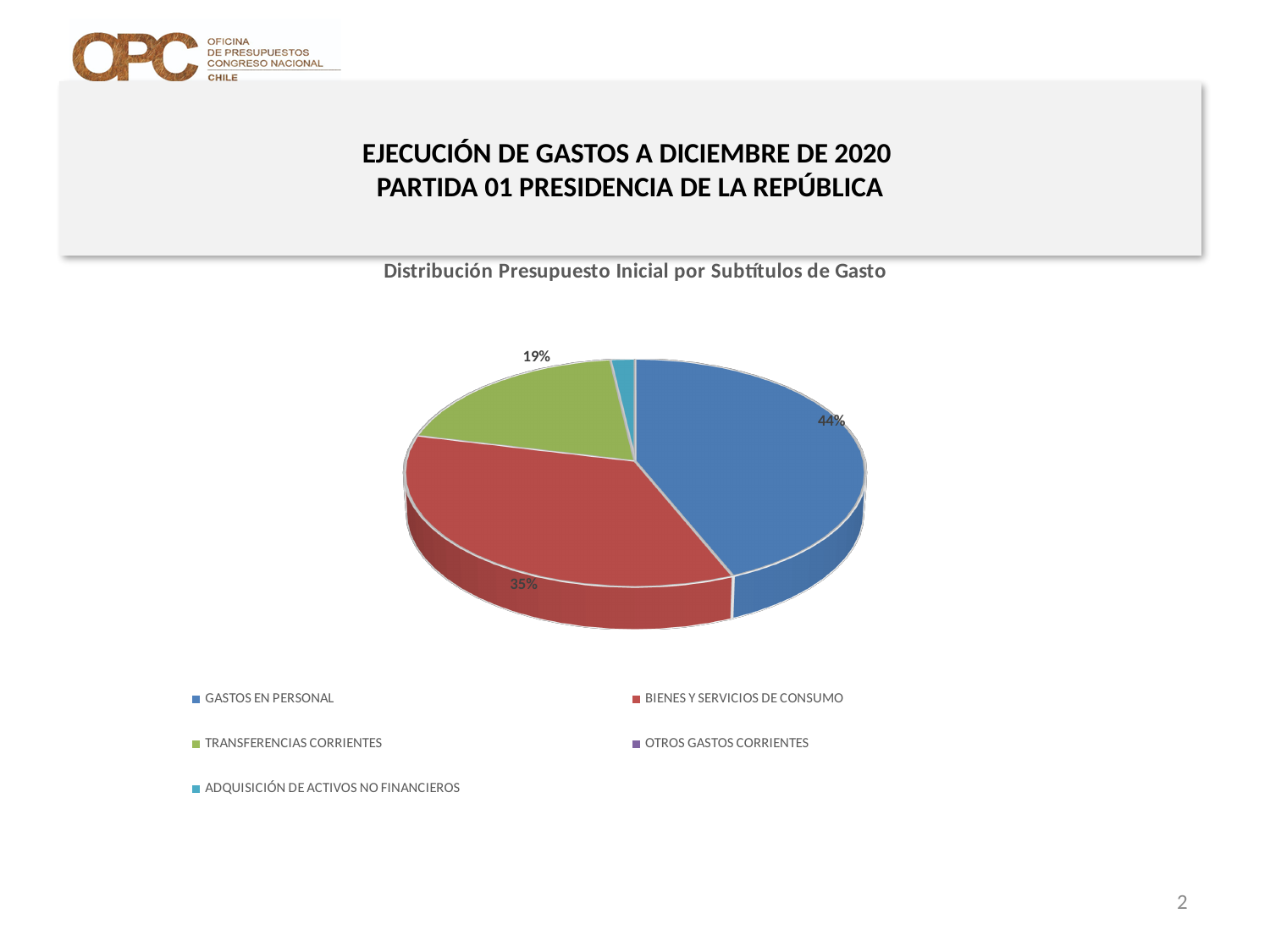
What percentage of the pie does GASTOS EN PERSONAL represent? 44% Which category has the largest share of the pie? GASTOS EN PERSONAL What is the difference in percentage points between GASTOS EN PERSONAL and BIENES Y SERVICIOS DE CONSUMO? 9 percentage points What is the difference in percentage points between BIENES Y SERVICIOS DE CONSUMO and TRANSFERENCIAS CORRIENTES? 16 percentage points Of the slices with a printed percentage, which has the smallest share? TRANSFERENCIAS CORRIENTES What percentage of the pie does TRANSFERENCIAS CORRIENTES represent? 19% How many categories does the legend list? 5 What is the title of the chart? Distribución Presupuesto Inicial por Subtítulos de Gasto Which colour represents GASTOS EN PERSONAL in the chart? Blue What type of chart is shown on the slide? Pie chart Which is larger, the share for BIENES Y SERVICIOS DE CONSUMO or the share for TRANSFERENCIAS CORRIENTES? BIENES Y SERVICIOS DE CONSUMO What percentage of the pie does BIENES Y SERVICIOS DE CONSUMO represent? 35%